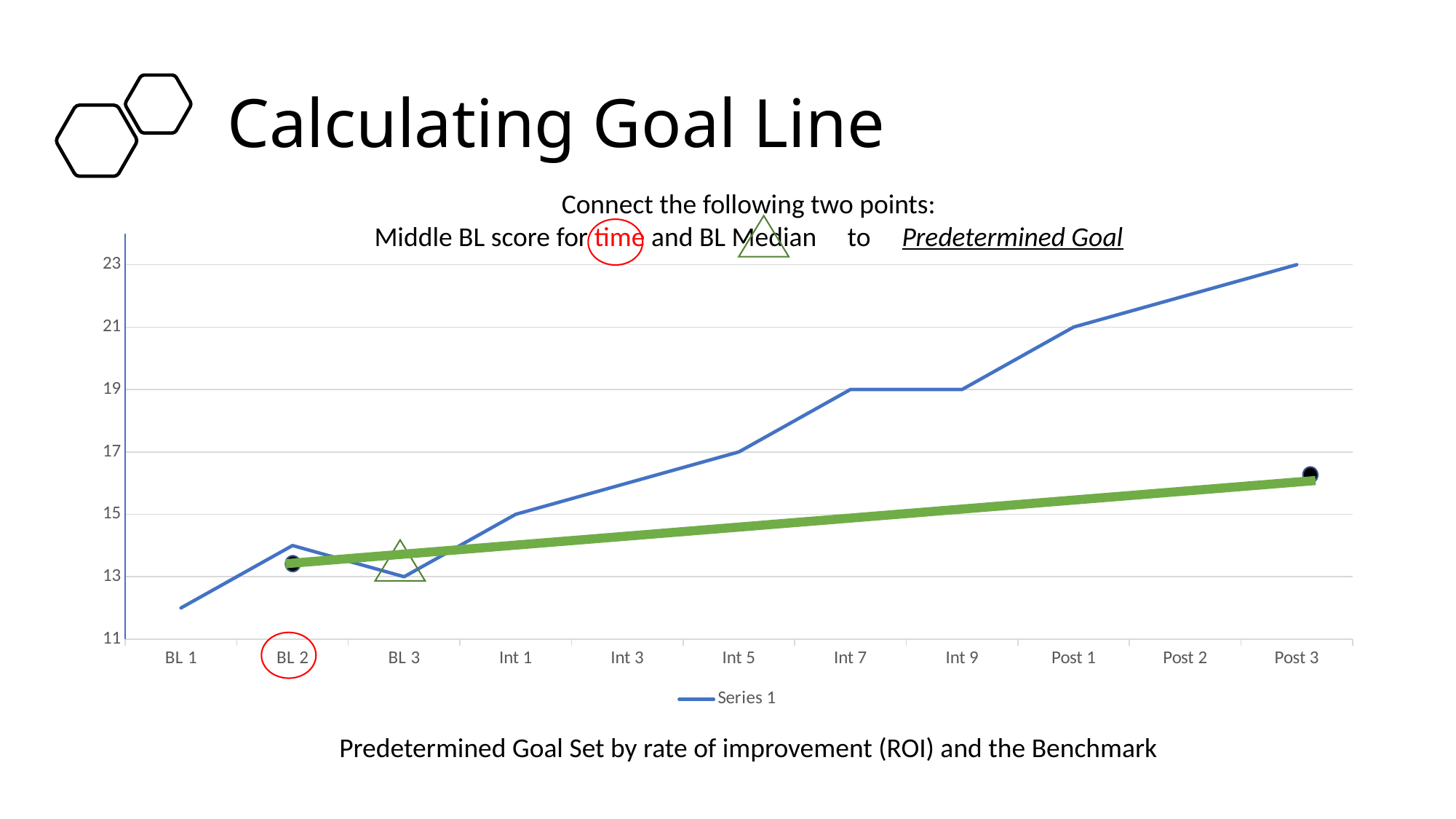
What is the difference between the Series 1 values at Post 3 and BL 3? 10 Which category has the highest value for Series 1? Post 3 How many series does the chart legend list? 1 What is the value of Series 1 at BL 3? 13 Do the Series 1 values generally rise or fall from BL 1 to Post 3? rise What is the value of Series 1 at Post 3? 23 Is the value for BL 1 greater or less than 13? less What kind of chart is shown on the slide? line chart What is the value of Series 1 at Int 7? 19 How many categories are shown on the x axis of the chart? 11 Which category has the lowest value for Series 1? BL 1 What is the value of Series 1 at Int 1? 15